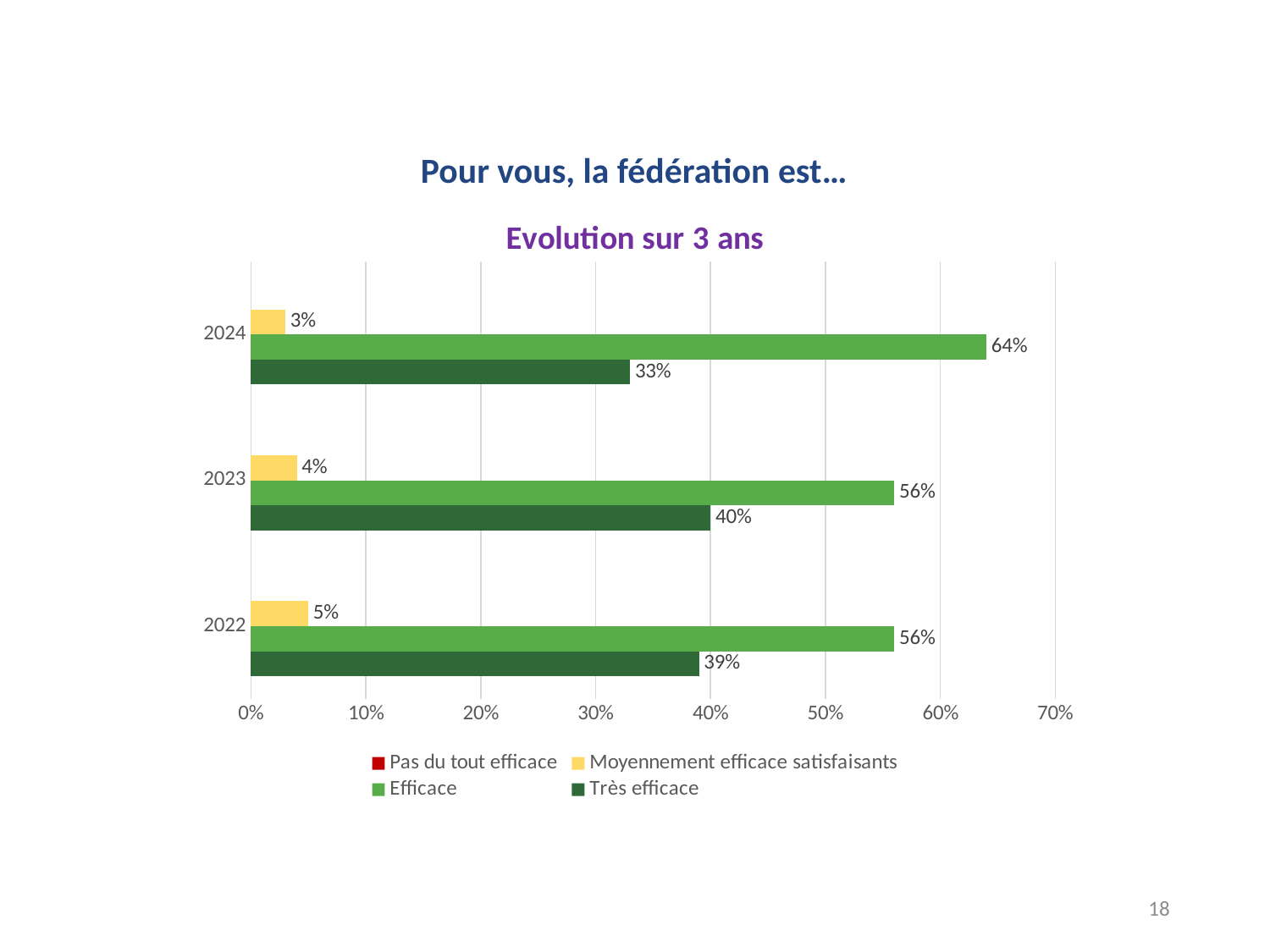
How many series does the legend list? 4 Is the Très efficace value for 2024 greater or less than 40%? less What is the value for Très efficace in 2023? 40% What is the difference between the Efficace values for 2024 and 2023? 8% In which year is the Moyennement efficace satisfaisants value lowest? 2024 What kind of chart is shown on the slide? bar chart What is the value for Moyennement efficace satisfaisants in 2022? 5% In which year is the Efficace value highest? 2024 What is the value for Efficace in 2024? 64% How many years are shown on the chart? 3 What is the title of the chart? Evolution sur 3 ans Which is larger, the Très efficace value for 2022 or for 2024? 2022